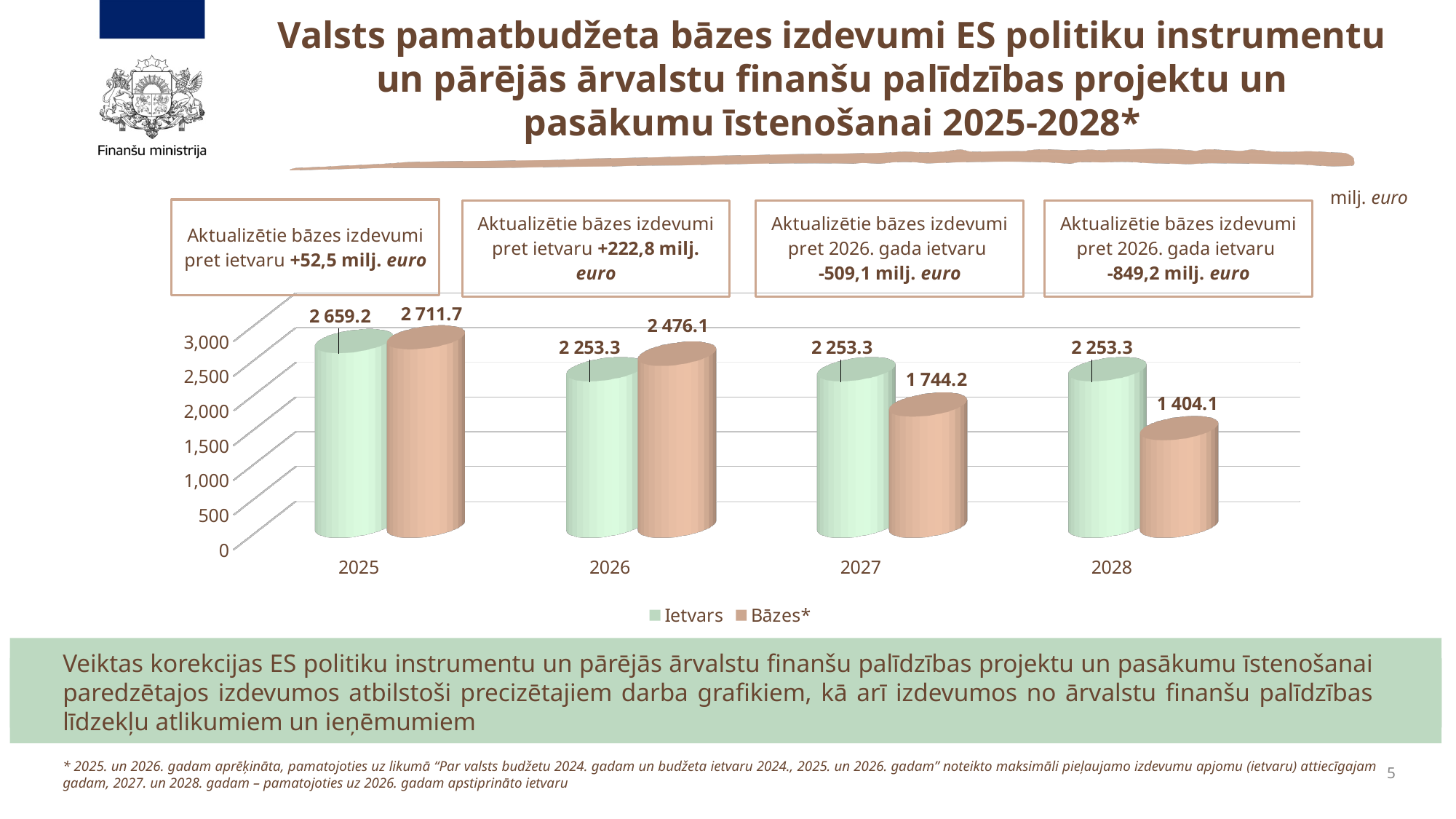
What is the value of the Bāzes* series for 2028? 1 404.1 What is the value of the Ietvars series for 2025? 2 659.2 How many series does the chart legend list? 2 For 2028, which series has the larger value, Ietvars or Bāzes*? Ietvars In which year is the Bāzes* series lowest? 2028 What is the difference between the Bāzes* and Ietvars values for 2027? 509.1 How many years are shown on the x axis of the chart? 4 What is the difference between the Bāzes* and Ietvars values for 2025? 52.5 Does the Bāzes* series rise or fall from 2025 to 2028? fall In which year is the Bāzes* series highest? 2025 What is the value of the Bāzes* series for 2026? 2 476.1 For 2026, which series has the larger value, Ietvars or Bāzes*? Bāzes*